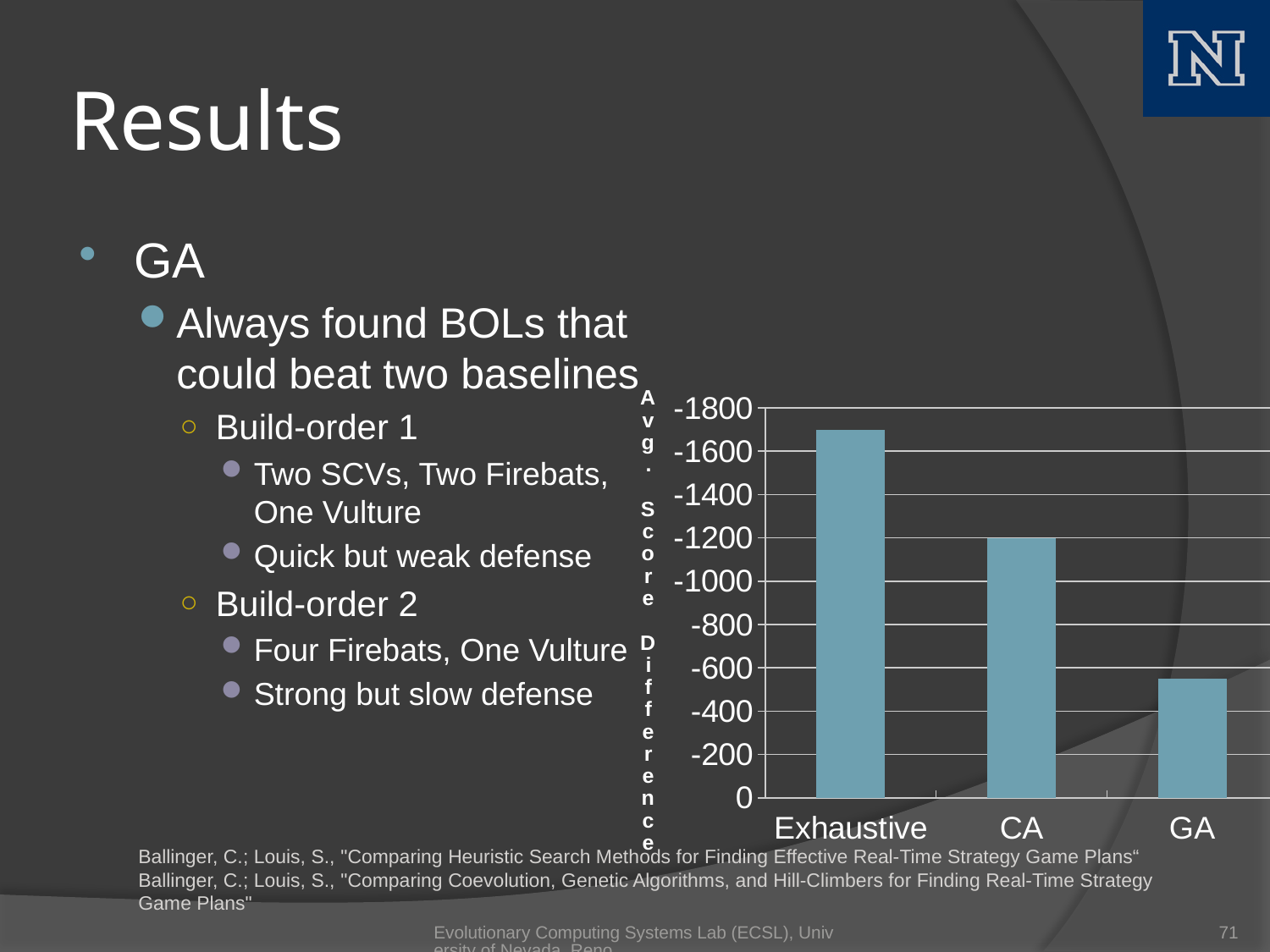
Does the bar for Exhaustive extend beyond the -1600 gridline? yes Does the bar for GA extend beyond the -600 gridline? no Which category has the shortest bar in the chart? GA Which category has the tallest bar in the chart? Exhaustive Which bar is taller in the chart, CA or GA? CA What kind of chart is shown on the slide? bar chart How many categories are shown on the x axis of the chart? 3 What is the value for CA in the chart? -1200 What is the title of the vertical axis of the chart? Avg. Score Difference Do the bar heights rise or fall from left to right across the x axis? fall Which bar is taller in the chart, Exhaustive or CA? Exhaustive What are the three categories on the x axis of the chart? Exhaustive, CA, GA